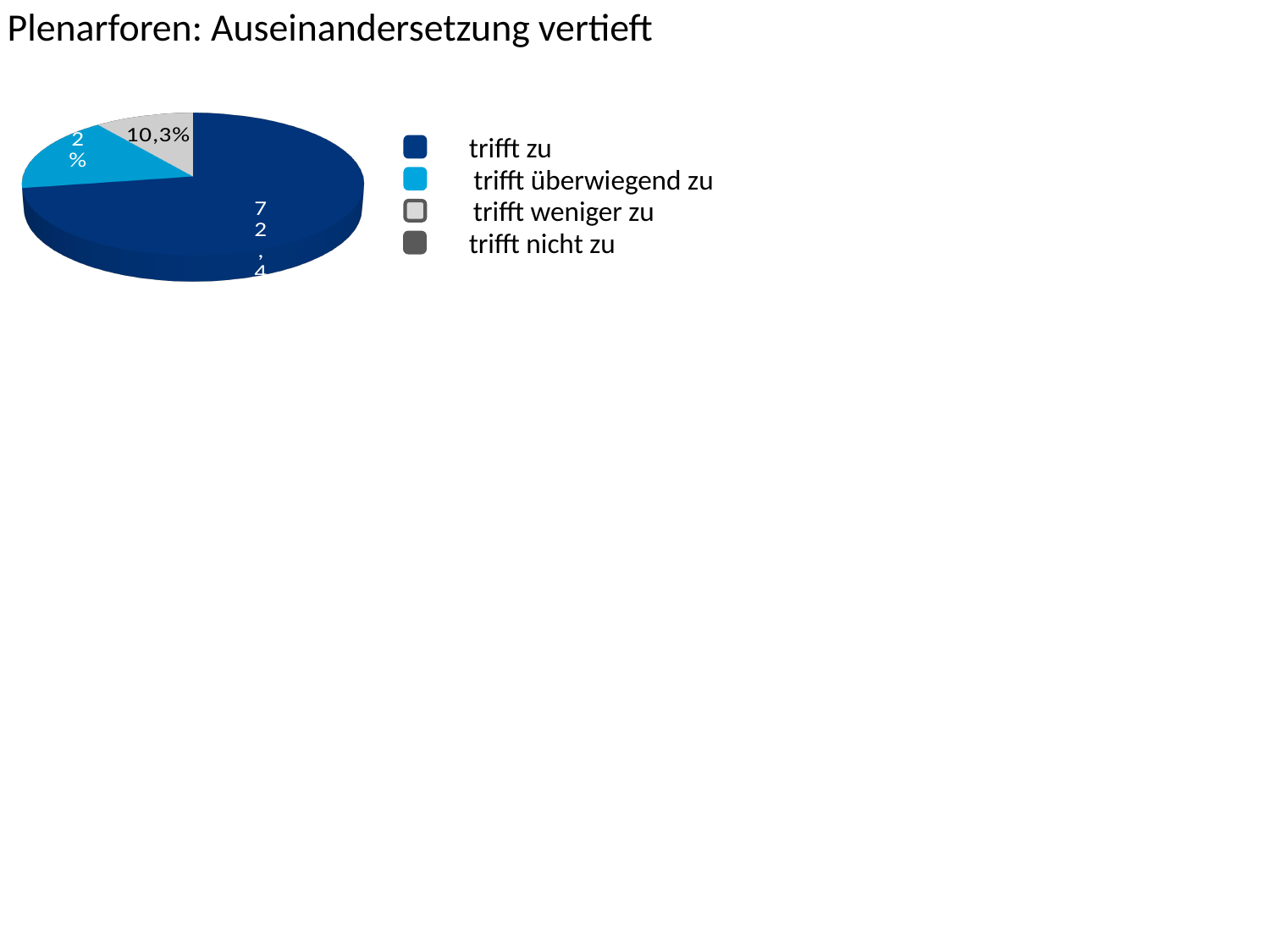
Which is larger, the slice for "trifft zu" or the slice for "trifft überwiegend zu"? trifft zu Which colour represents "trifft zu" in the legend? dark blue What kind of chart is shown on the slide? pie chart How many entries does the legend of the pie chart list? 4 What share of the pie does "trifft weniger zu" have? 10,3% Which is larger, the slice for "trifft überwiegend zu" or the slice for "trifft weniger zu"? trifft überwiegend zu What is the title of the chart on the slide? Plenarforen: Auseinandersetzung vertieft Which category has the largest slice of the pie? trifft zu What value is printed on the grey slice of the pie chart? 10,3%